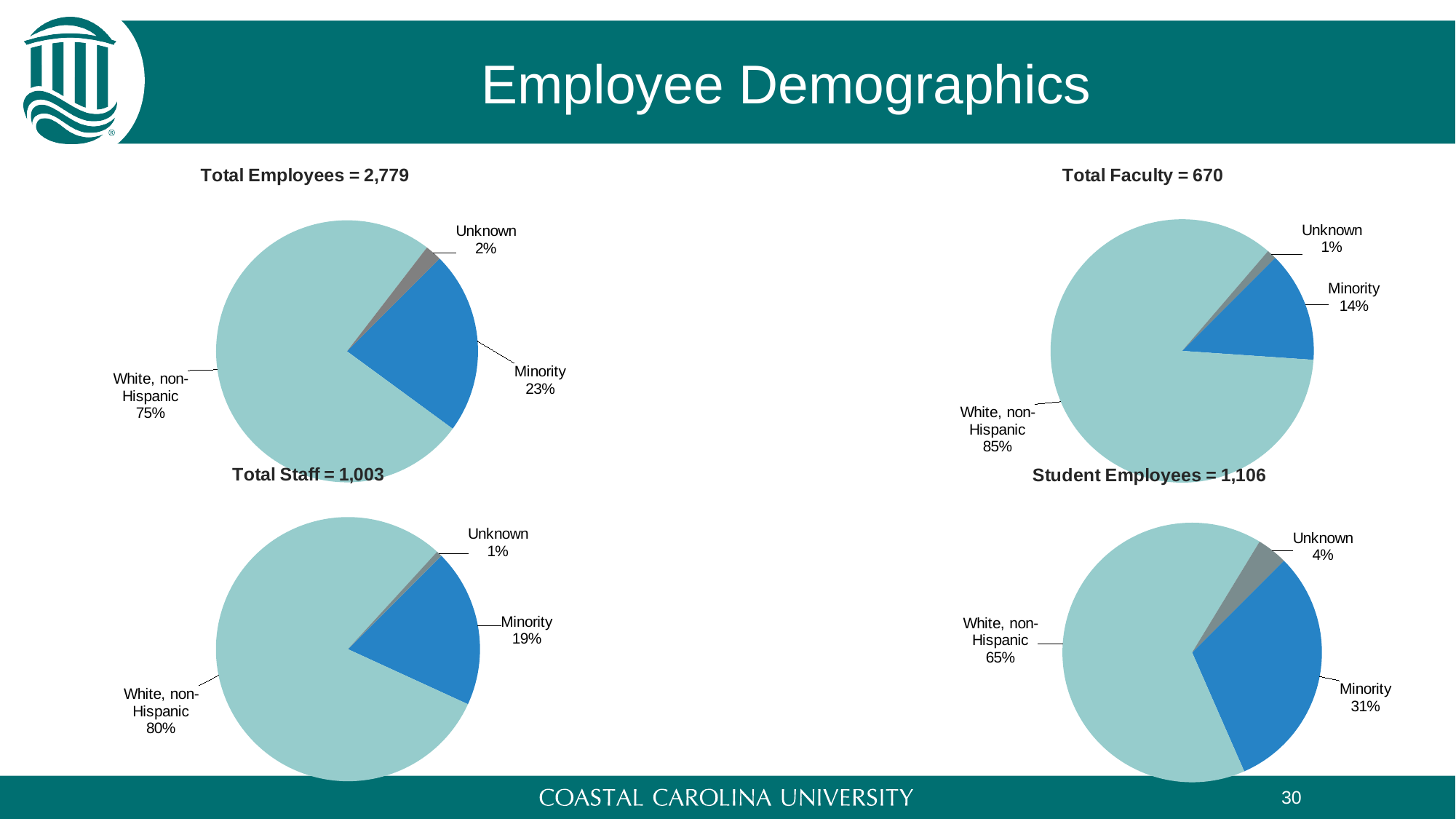
In the 'Total Employees = 2,779' chart, what is the difference between the White, non-Hispanic and Minority shares? 52% In the 'Total Staff = 1,003' chart, what is the value for Unknown? 1% How many categories does the 'Total Staff = 1,003' chart show? 3 In the 'Student Employees = 1,106' chart, what is the value for Minority? 31% In the 'Student Employees = 1,106' chart, which category has the smallest slice? Unknown What is the title of the chart in the bottom-right of the slide? Student Employees = 1,106 Which is larger: the Minority share in the 'Total Staff = 1,003' chart or the Minority share in the 'Student Employees = 1,106' chart? Student Employees = 1,106 How many pie charts are on the slide? 4 What kind of chart is the 'Total Employees = 2,779' chart? Pie chart In the 'Total Employees = 2,779' chart, what share of the pie is Minority? 23% In the 'Total Faculty = 670' chart, what share of the pie is White, non-Hispanic? 85% In the 'Total Faculty = 670' chart, which category has the largest slice? White, non-Hispanic